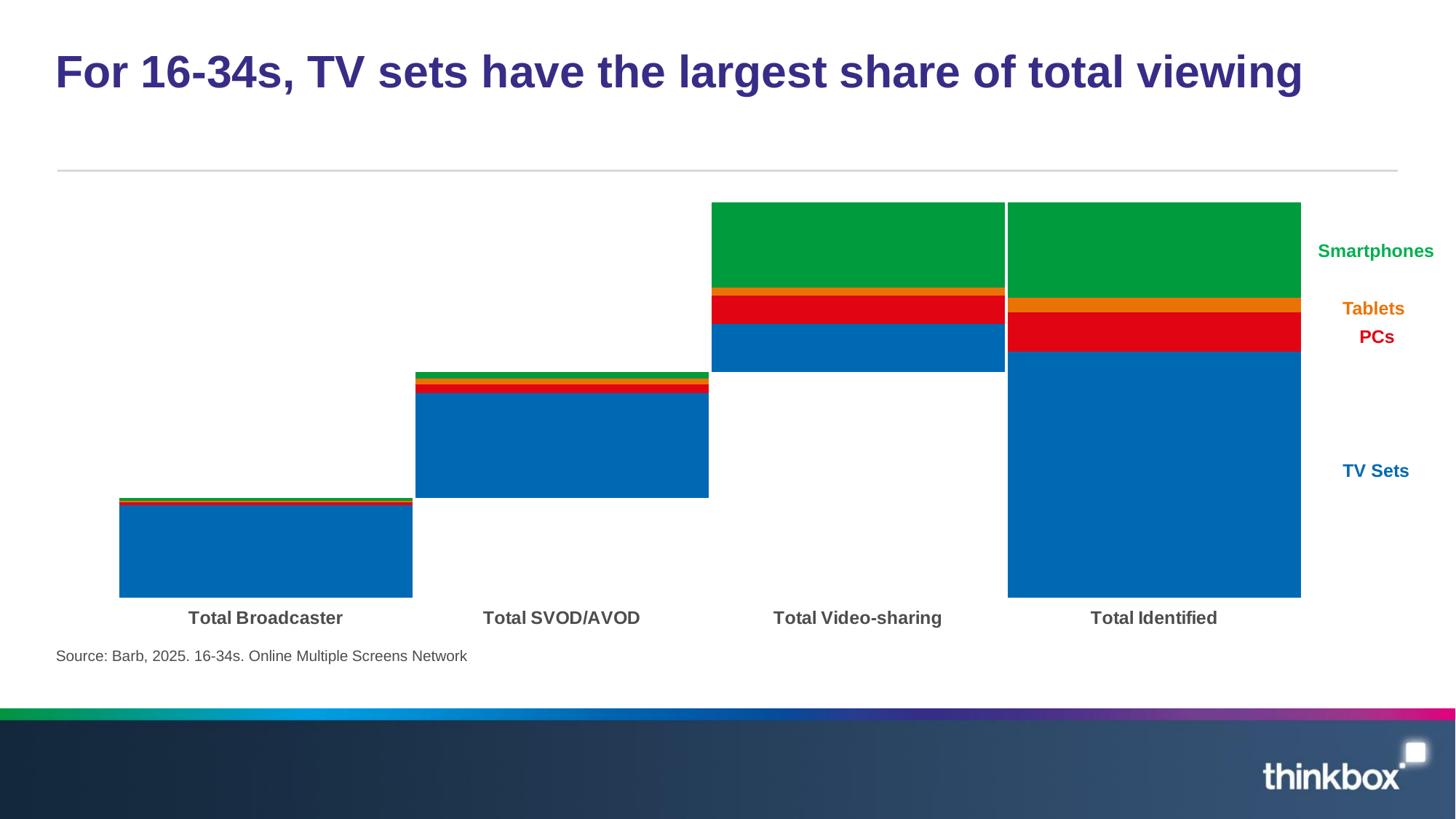
Which colour represents TV Sets in the chart? Blue In the Total Video-sharing bar, is the Smartphones segment larger or smaller than the TV Sets segment? Larger Which category has the smallest Smartphones segment? Total Broadcaster Which device type is shown in green in the chart? Smartphones Which category has the largest TV Sets segment? Total Identified In the Total Video-sharing bar, which is larger: the PCs segment or the Tablets segment? PCs How many categories are shown along the x axis of the chart? 4 In the Total Video-sharing bar, which device has the smallest segment? Tablets In the Total Identified bar, which is larger: the TV Sets segment or the Smartphones segment? TV Sets How many device series does the chart's legend list? 4 In the Total Identified bar, which device has the largest segment? TV Sets What kind of chart is shown on the slide? Stacked bar chart